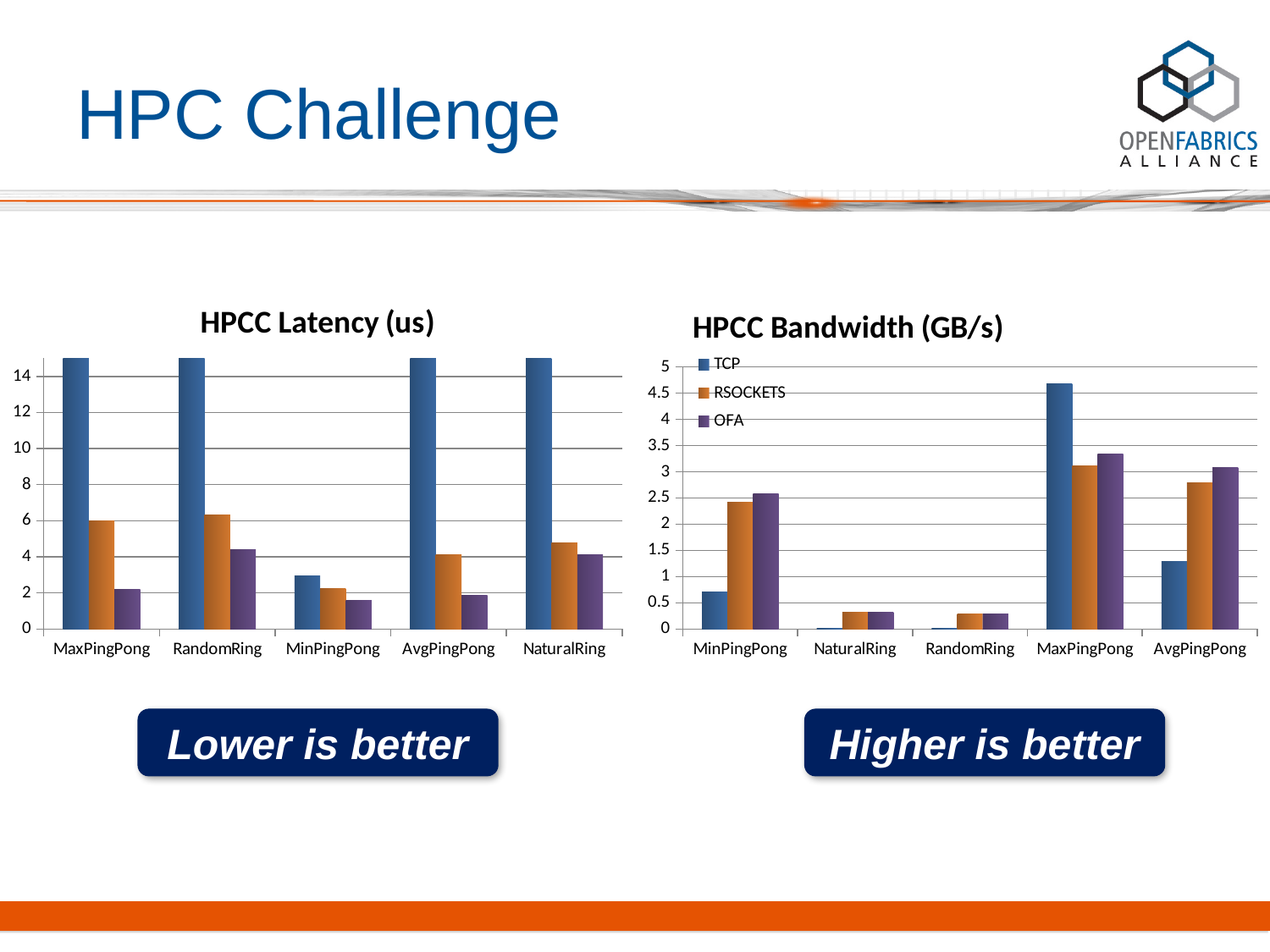
How many categories are shown on the x axis of the HPCC Latency (us) chart? 5 In the HPCC Latency (us) chart, is the blue bar for MaxPingPong greater or less than 14? greater What are the legend entries of the HPCC Bandwidth (GB/s) chart? TCP, RSOCKETS, OFA In the HPCC Bandwidth (GB/s) chart, which category has the highest TCP value? MaxPingPong What kind of chart is the HPCC Latency (us) chart? bar chart How many series does the legend of the HPCC Bandwidth (GB/s) chart list? 3 In the HPCC Latency (us) chart, which category has the lowest blue bar? MinPingPong In the HPCC Bandwidth (GB/s) chart, is the TCP value for MaxPingPong greater or less than 4? greater In the HPCC Bandwidth (GB/s) chart, which is larger for AvgPingPong: RSOCKETS or TCP? RSOCKETS In the HPCC Bandwidth (GB/s) chart, which is larger for MaxPingPong: TCP or OFA? TCP In the HPCC Bandwidth (GB/s) chart, is the TCP value for MinPingPong greater or less than 1? less What is the title of the chart on the right side of the slide? HPCC Bandwidth (GB/s)